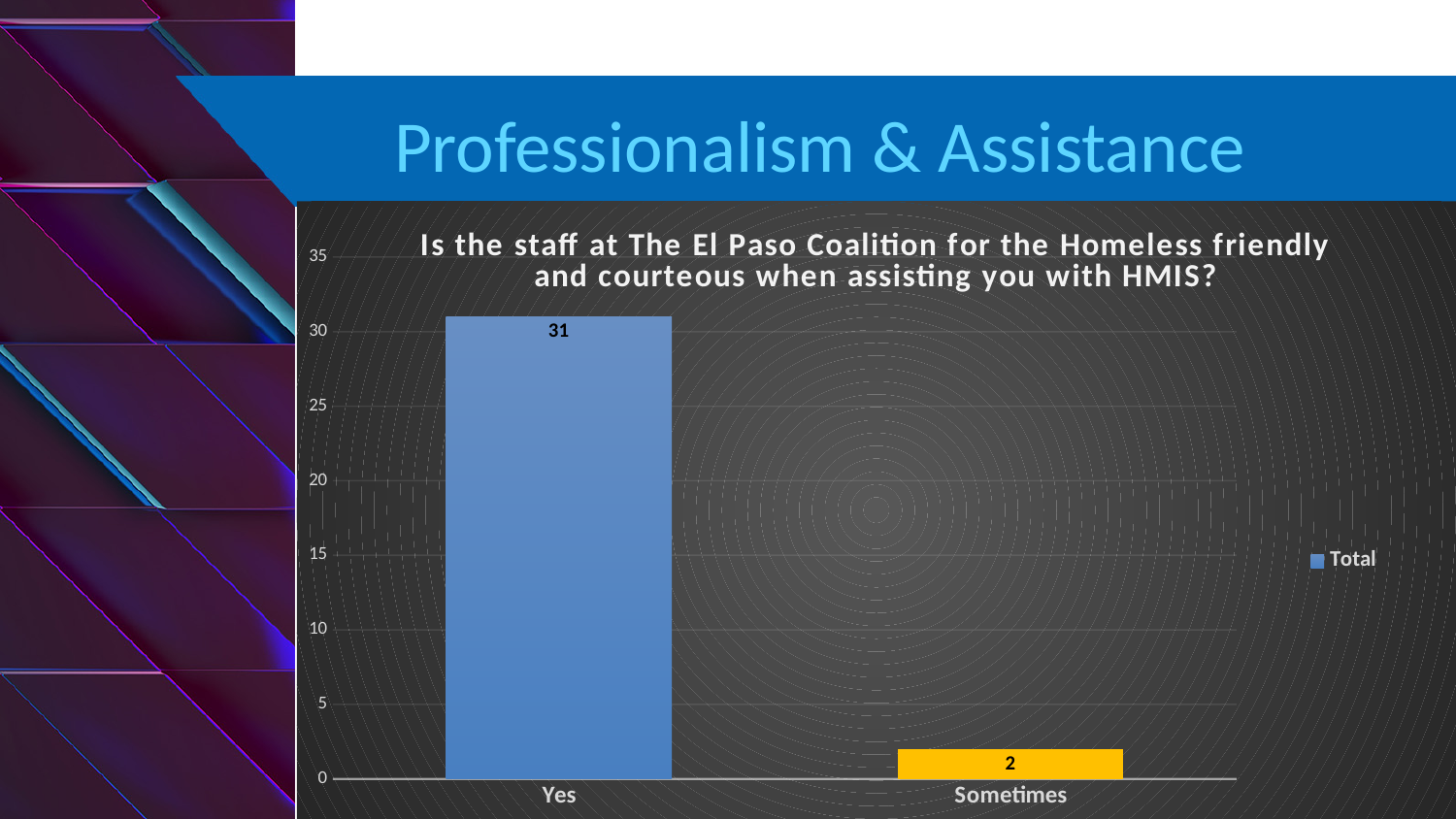
Which category has the highest value? Yes What is the value for Sometimes? 2 Which category has the lowest value? Sometimes What is the name of the series listed in the legend? Total Is the value for Yes greater or less than 30? greater How many series does the legend list? 1 How many categories are shown on the x axis? 2 Which is larger, the value for Yes or the value for Sometimes? Yes What is the difference between the values for Yes and Sometimes? 29 Is the value for Sometimes greater or less than 5? less What kind of chart is shown? bar chart What is the value for Yes? 31